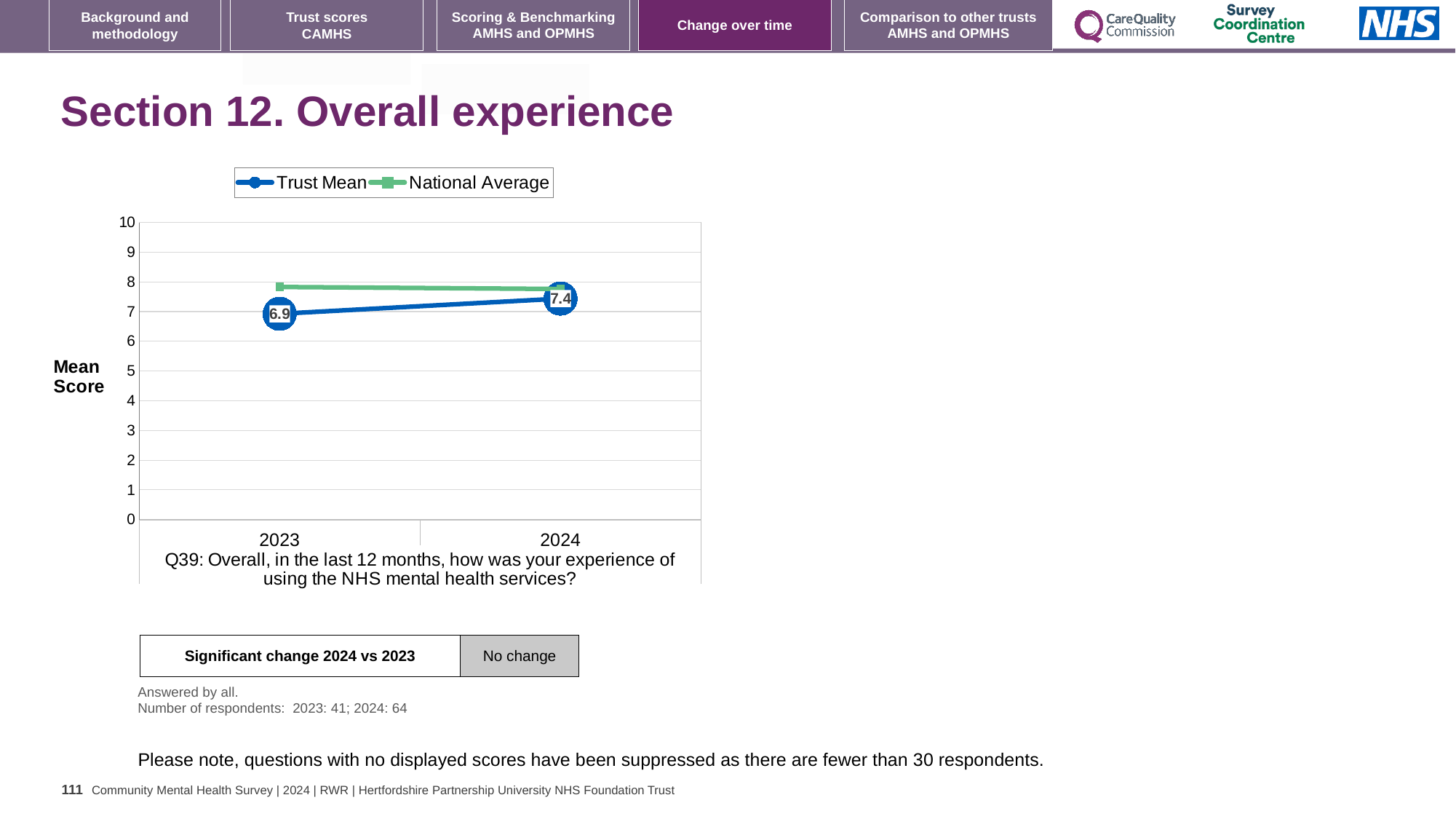
What is the Trust Mean score for 2024? 7.4 By how much did the Trust Mean score change from 2023 to 2024? 0.5 In which year is the Trust Mean score higher? 2024 What is the Trust Mean score for 2023? 6.9 What are the two series named in the chart legend? Trust Mean and National Average In 2023, which is higher: the Trust Mean or the National Average? National Average How many series does the legend list? 2 What kind of chart is shown on the slide? line chart How many years are plotted on the x axis? 2 What is the label on the y axis of the chart? Mean Score Is the National Average value for 2023 greater or less than 7? greater Does the Trust Mean line rise or fall from 2023 to 2024? rises